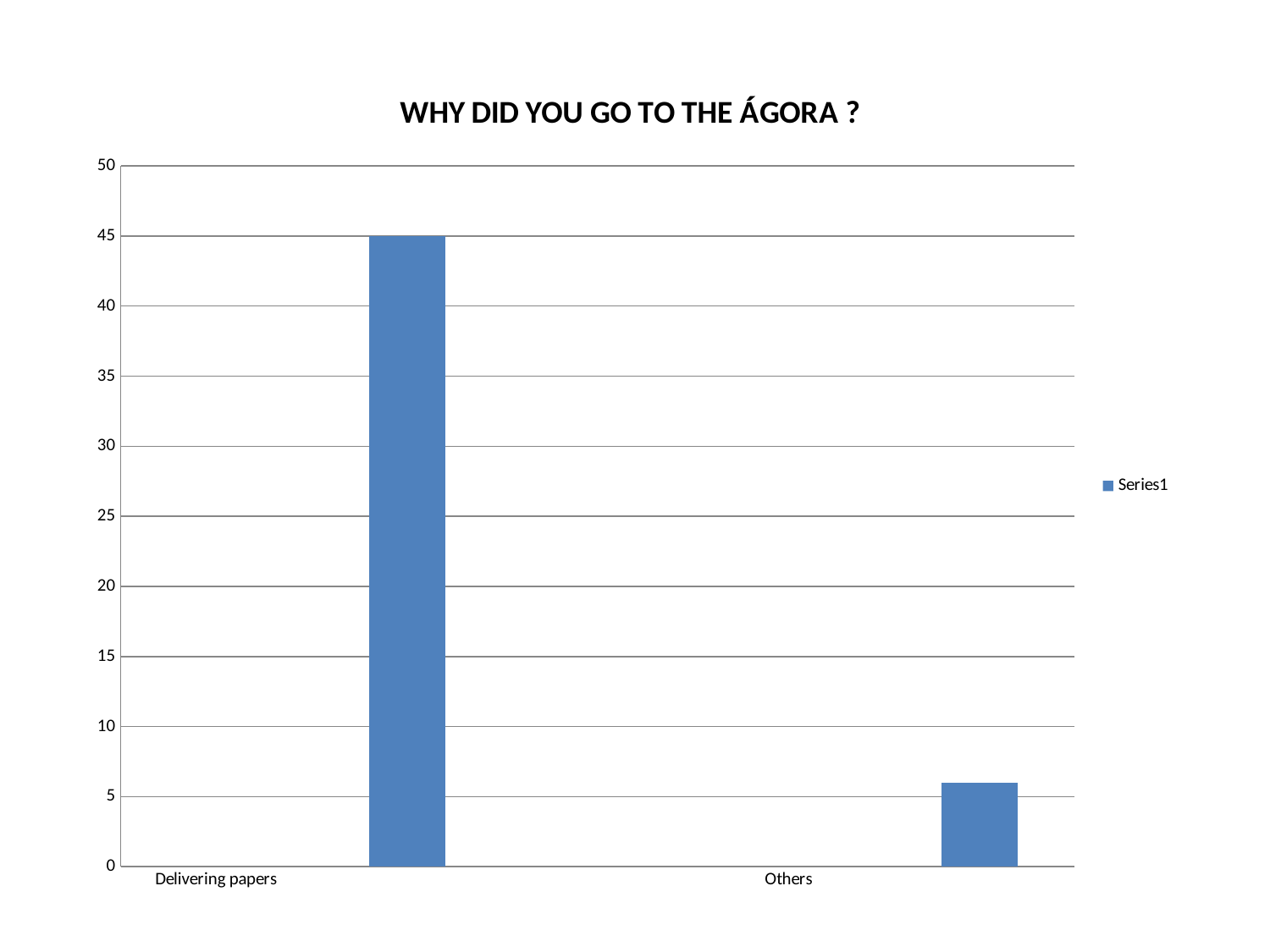
Which category has the lowest value? Others What is the value for Delivering papers? 45 What is the name of the series shown in the legend? Series1 What is the title of the chart? WHY DID YOU GO TO THE ÁGORA ? Is the value for Delivering papers greater or less than 40? greater Which is larger, the value for Delivering papers or the value for Others? Delivering papers Is the value for Others greater or less than 5? greater Which category has the highest value? Delivering papers What kind of chart is shown on the slide? bar chart How many categories are shown on the x axis of the chart? 2 Is the value for Others greater or less than 10? less How many series does the legend list? 1